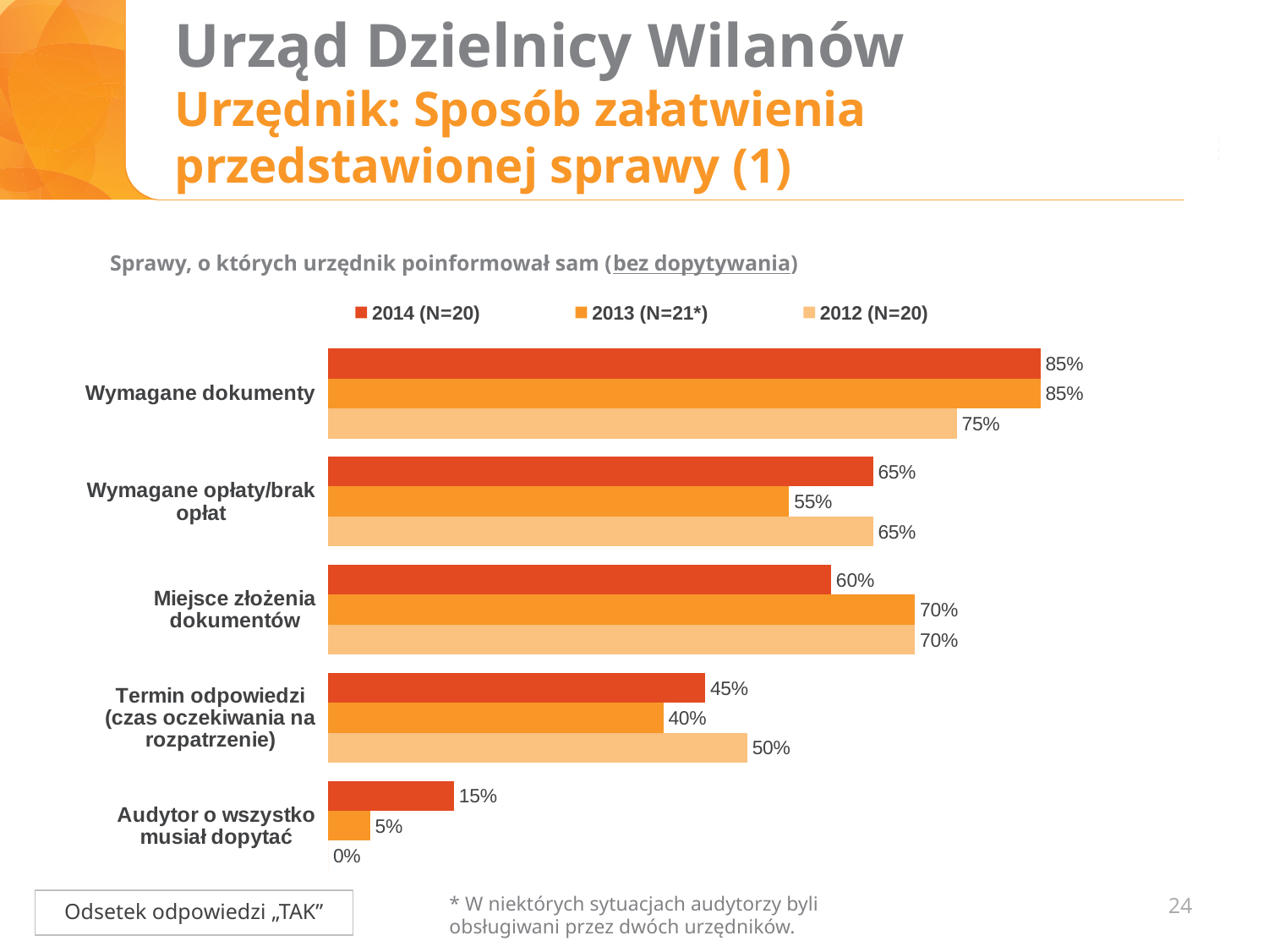
Which category has the highest value in the 2014 (N=20) series? Wymagane dokumenty What is the value for "Wymagane opłaty/brak opłat" in the 2013 (N=21*) series? 55% For "Miejsce złożenia dokumentów", which is larger: the 2014 (N=20) value or the 2013 (N=21*) value? 2013 (N=21*) What is the difference between the 2014 (N=20) and 2012 (N=20) values for "Wymagane dokumenty"? 10% How many categories are shown on the chart? 5 Which category has the lowest value in the 2013 (N=21*) series? Audytor o wszystko musiał dopytać What is the difference between the 2014 (N=20) and 2013 (N=21*) values for "Audytor o wszystko musiał dopytać"? 10% What is the value for "Wymagane dokumenty" in the 2014 (N=20) series? 85% What is the value for "Termin odpowiedzi (czas oczekiwania na rozpatrzenie)" in the 2012 (N=20) series? 50% How many series does the legend list? 3 What kind of chart is shown on the slide? Bar chart What is the value for "Audytor o wszystko musiał dopytać" in the 2012 (N=20) series? 0%